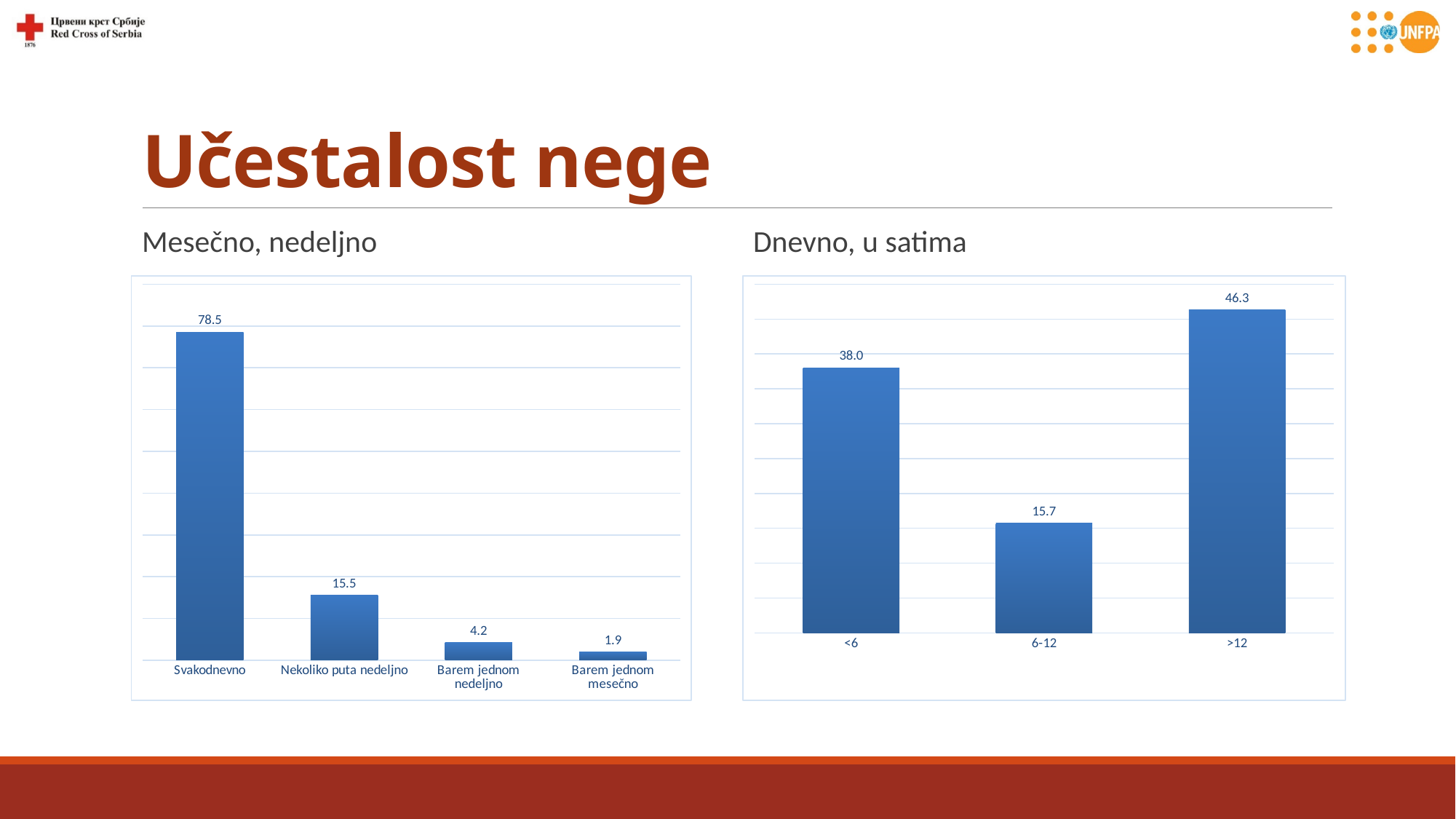
In the 'Dnevno, u satima' chart, how many categories are shown? 3 In the 'Mesečno, nedeljno' chart, what is the difference between Svakodnevno and Nekoliko puta nedeljno? 63.0 In the 'Dnevno, u satima' chart, which is larger, <6 or 6-12? <6 In the 'Mesečno, nedeljno' chart, what is the value for Nekoliko puta nedeljno? 15.5 In the 'Mesečno, nedeljno' chart, do the values rise or fall from left to right? fall In the 'Mesečno, nedeljno' chart, which category has the lowest value? Barem jednom mesečno What type of chart is the 'Dnevno, u satima' chart? bar chart In the 'Dnevno, u satima' chart, what is the difference between >12 and <6? 8.3 In the 'Mesečno, nedeljno' chart, how many categories are shown? 4 In the 'Dnevno, u satima' chart, which category has the highest value? >12 In the 'Dnevno, u satima' chart, what is the value for 6-12? 15.7 In the 'Mesečno, nedeljno' chart, what is the value for Svakodnevno? 78.5